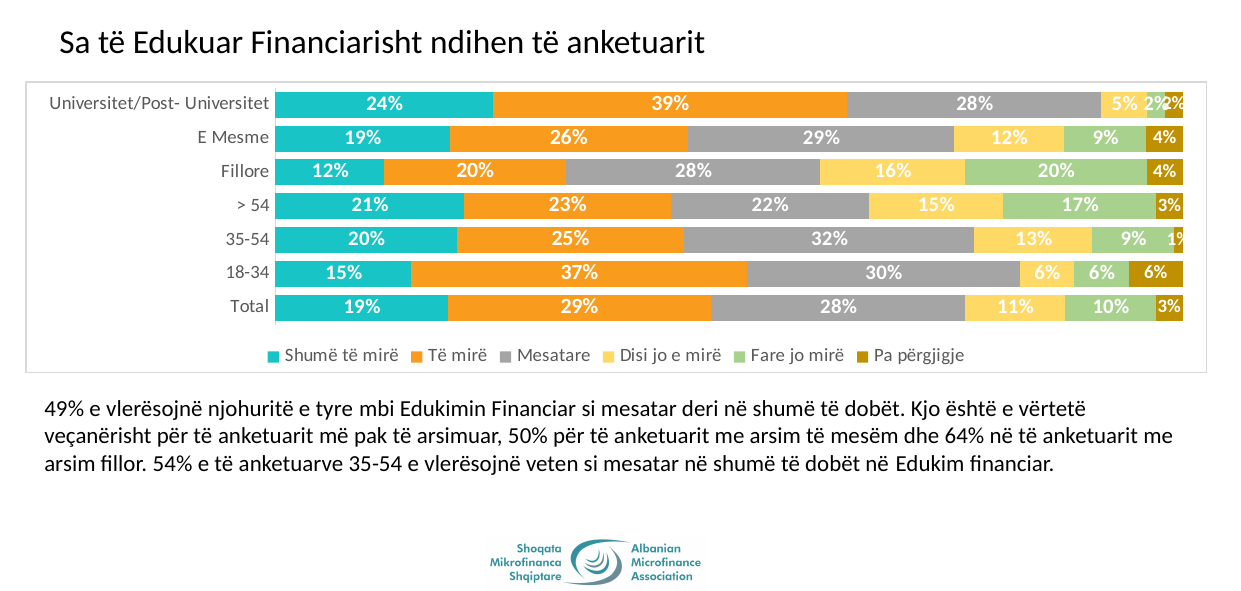
What is the value of "Mesatare" for 35-54? 32% How many series does the legend list? 6 What is the value of "Fare jo mirë" for Fillore? 20% What is the value of "Shumë të mirë" for Total? 19% What is the title of the chart? Sa të Edukuar Financiarisht ndihen të anketuarit What kind of chart is shown on the slide? Stacked bar chart How many categories are shown on the vertical axis? 7 Which is larger: the "Disi jo e mirë" value for > 54 or for E Mesme? > 54 What is the difference between the "Të mirë" values for 18-34 and Fillore? 17% Which category has the highest value for "Shumë të mirë"? Universitet/Post- Universitet What is the value of "Të mirë" for Universitet/Post- Universitet? 39% Which category has the lowest value for "Shumë të mirë"? Fillore